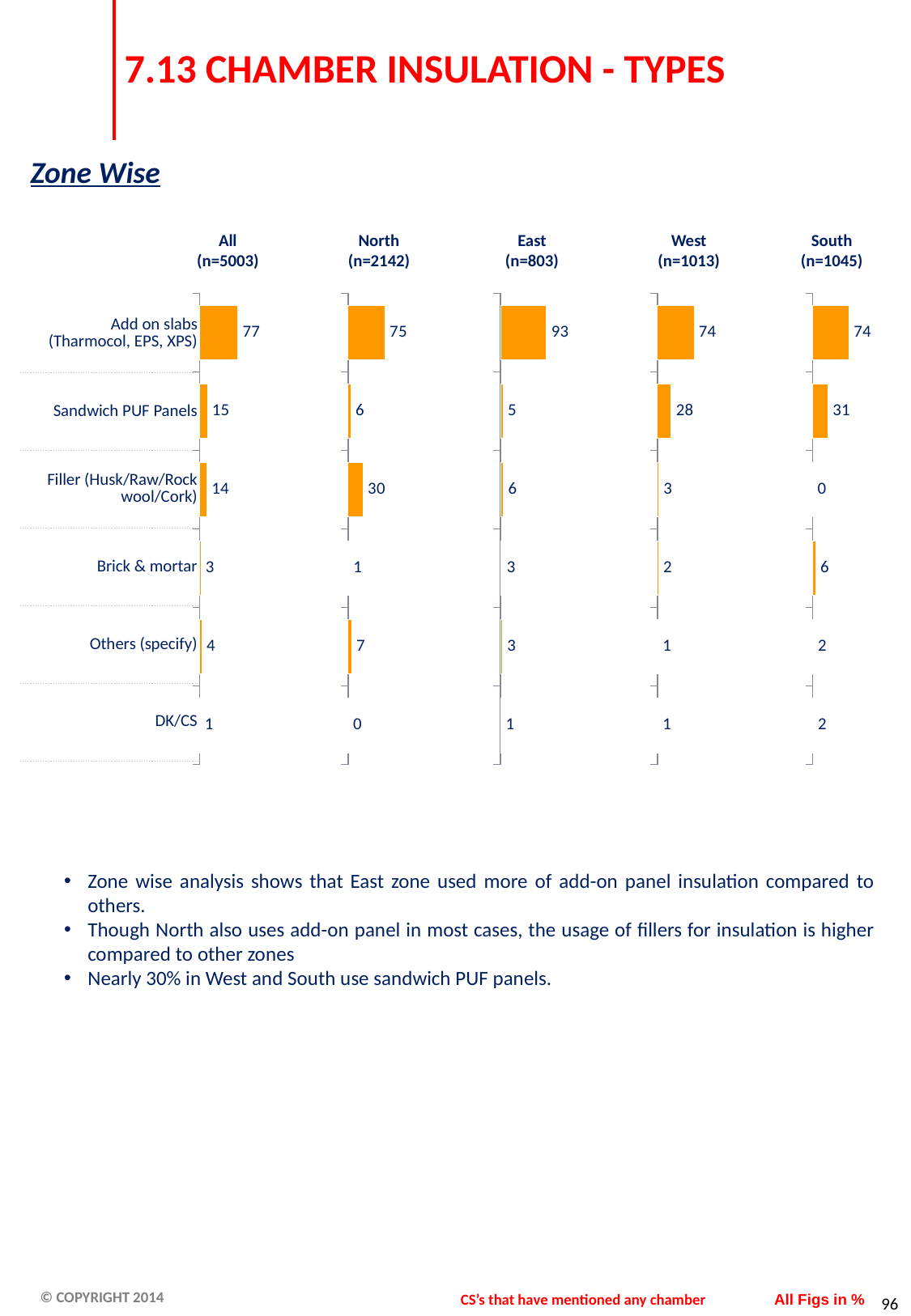
In the West (n=1013) chart, what is the difference between Add on slabs (Tharmocol, EPS, XPS) and Sandwich PUF Panels? 46 In the North (n=2142) chart, what is the value for Filler (Husk/Raw/Rock wool/Cork)? 30 In the South (n=1045) chart, what is the value for Sandwich PUF Panels? 31 How many separate zone charts are shown on the slide? 5 In the North (n=2142) chart, which category has the lowest value? DK/CS In the East (n=803) chart, what is the value for Add on slabs (Tharmocol, EPS, XPS)? 93 Which is larger: the Sandwich PUF Panels value in the West (n=1013) chart or in the South (n=1045) chart? South (n=1045) How many categories are shown in the All (n=5003) chart? 6 In the South (n=1045) chart, what is the value for Filler (Husk/Raw/Rock wool/Cork)? 0 What kind of chart is used for the All (n=5003) data? Bar chart In the All (n=5003) chart, what is the value for Add on slabs (Tharmocol, EPS, XPS)? 77 In the West (n=1013) chart, which category has the highest value? Add on slabs (Tharmocol, EPS, XPS)